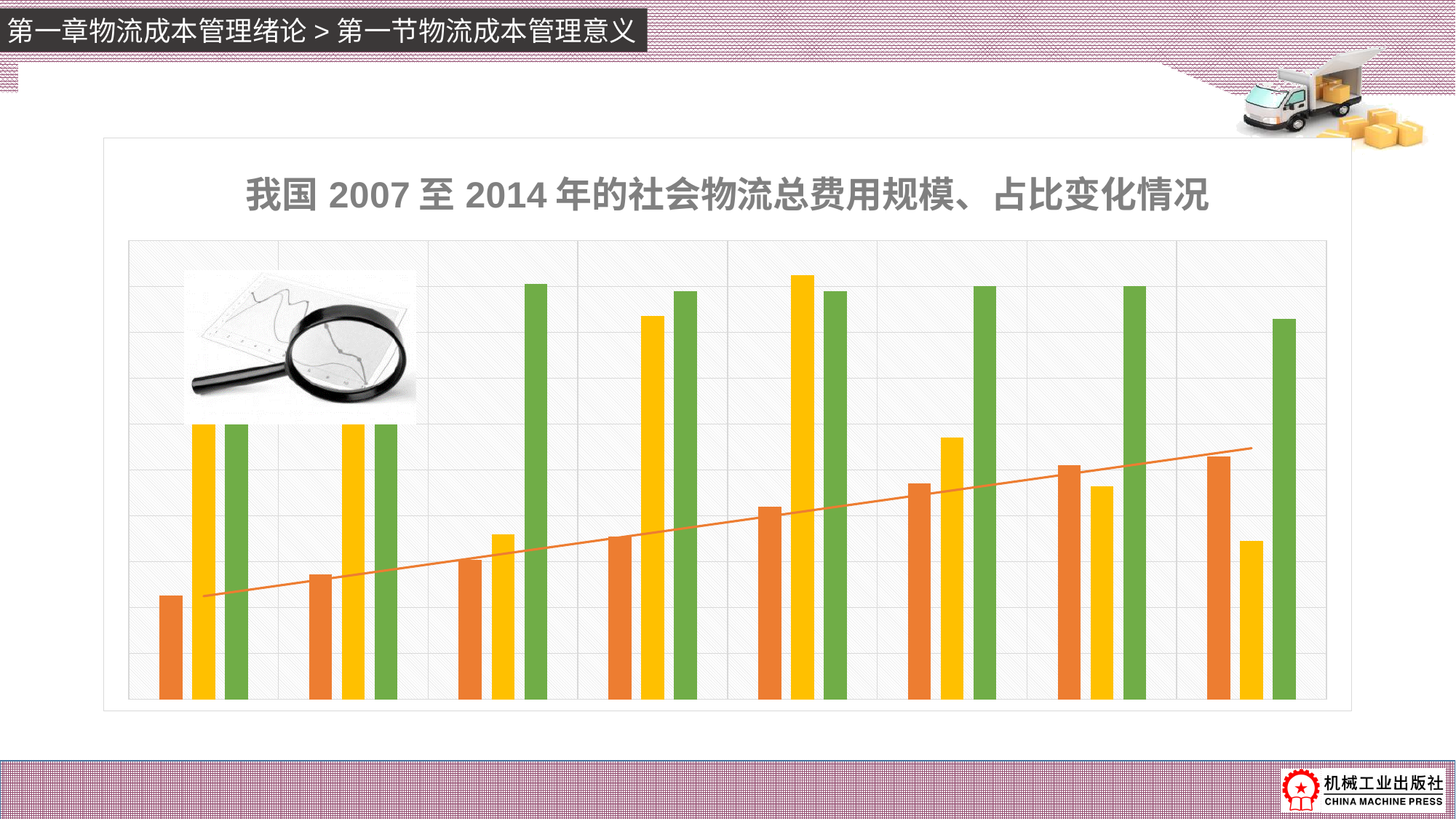
Do the orange bars rise or fall from left to right across the chart? rise What is the title of the chart? 我国 2007 至 2014 年的社会物流总费用规模、占比变化情况 How many groups of bars are plotted in the chart? 8 What kind of chart is shown on the slide? bar chart How many different bar colours are used in the chart? 3